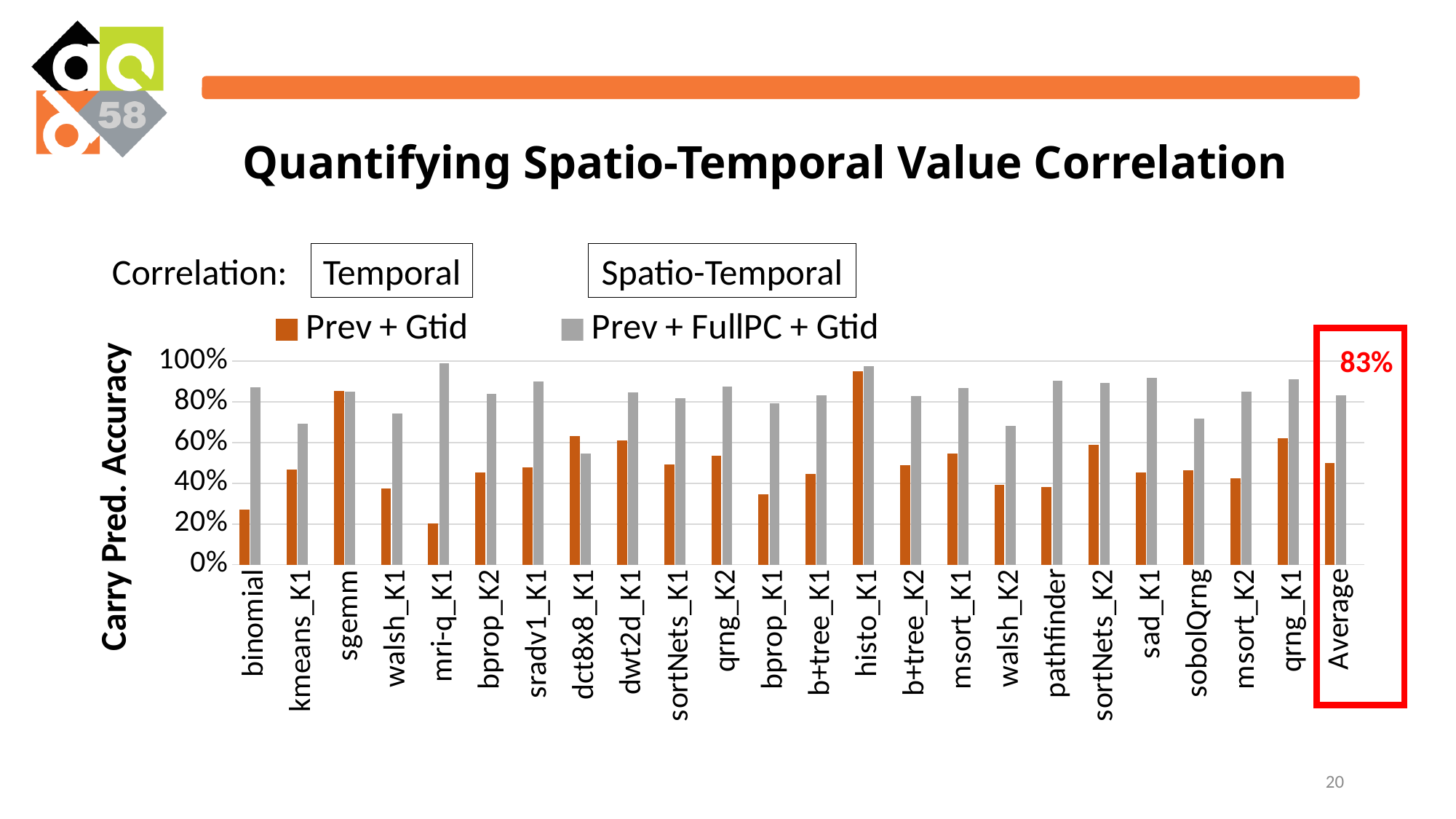
For dct8x8_K1, which series has the larger value, Prev + Gtid or Prev + FullPC + Gtid? Prev + Gtid What kind of chart is shown on the slide? bar chart How many series does the legend list? 2 Which category has the lowest Prev + Gtid value? mri-q_K1 What is the title of the y axis? Carry Pred. Accuracy What is the Prev + FullPC + Gtid value for Average? 83% Is the Prev + Gtid value for histo_K1 greater or less than 80%? greater Is the Prev + Gtid value for mri-q_K1 greater or less than 40%? less Which category has the highest Prev + Gtid value? histo_K1 Which category has the lowest Prev + FullPC + Gtid value? dct8x8_K1 How many categories are shown along the x axis? 24 Is the Prev + FullPC + Gtid value for mri-q_K1 greater or less than 80%? greater